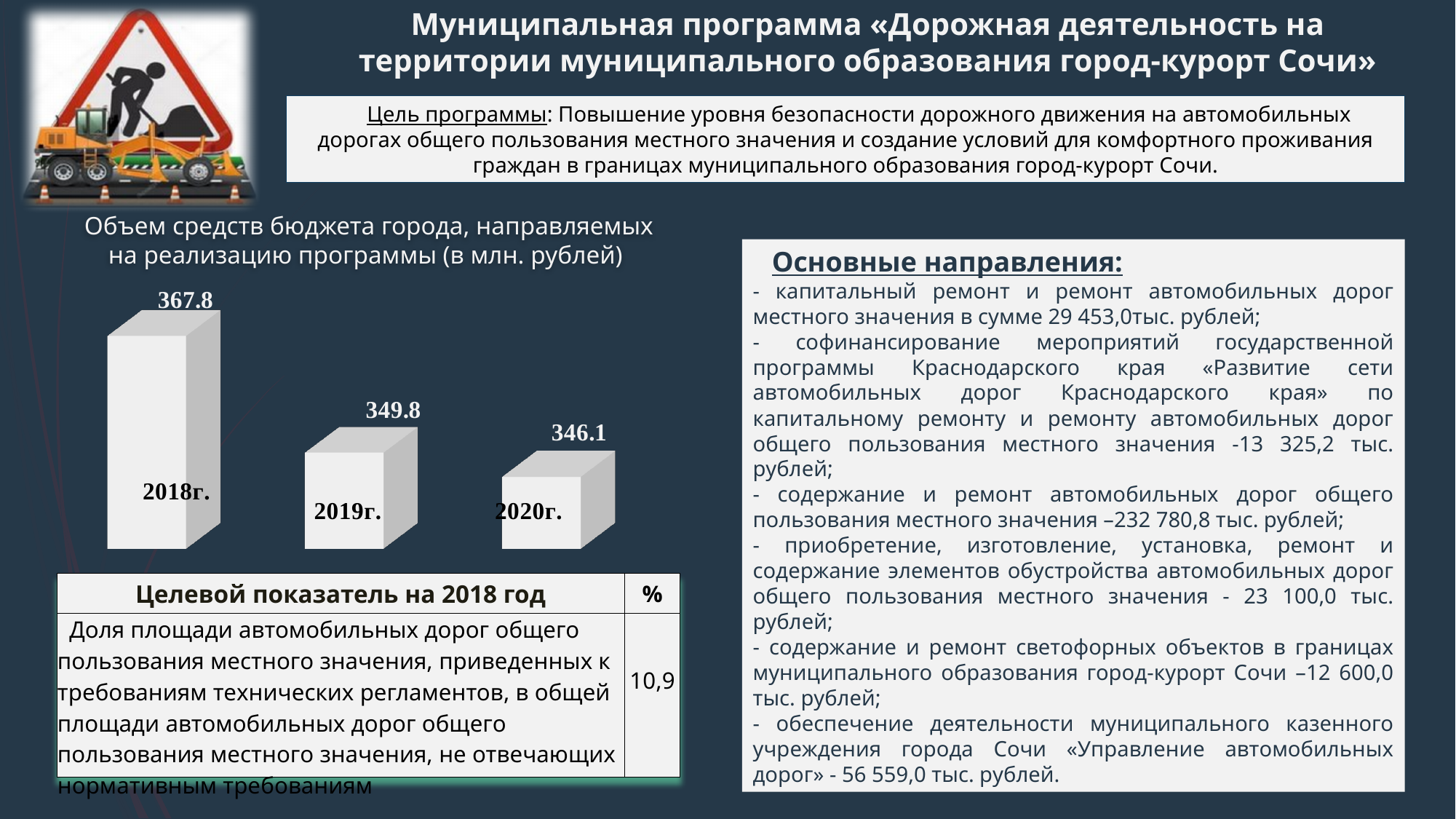
Which is larger, the value for 2018г. or the value for 2020г.? 2018г. What is the value for 2020г. in the chart? 346.1 Do the values rise or fall from 2018г. to 2020г.? fall What is the difference between the values for 2018г. and 2020г.? 21.7 What is the value for 2019г. in the chart? 349.8 Which year has the highest value in the chart? 2018г. What is the value for 2018г. in the chart? 367.8 Which year has the lowest value in the chart? 2020г. What is the difference between the values for 2018г. and 2019г.? 18.0 What kind of chart is shown on the slide? bar chart What is the difference between the values for 2019г. and 2020г.? 3.7 How many years are shown in the chart? 3